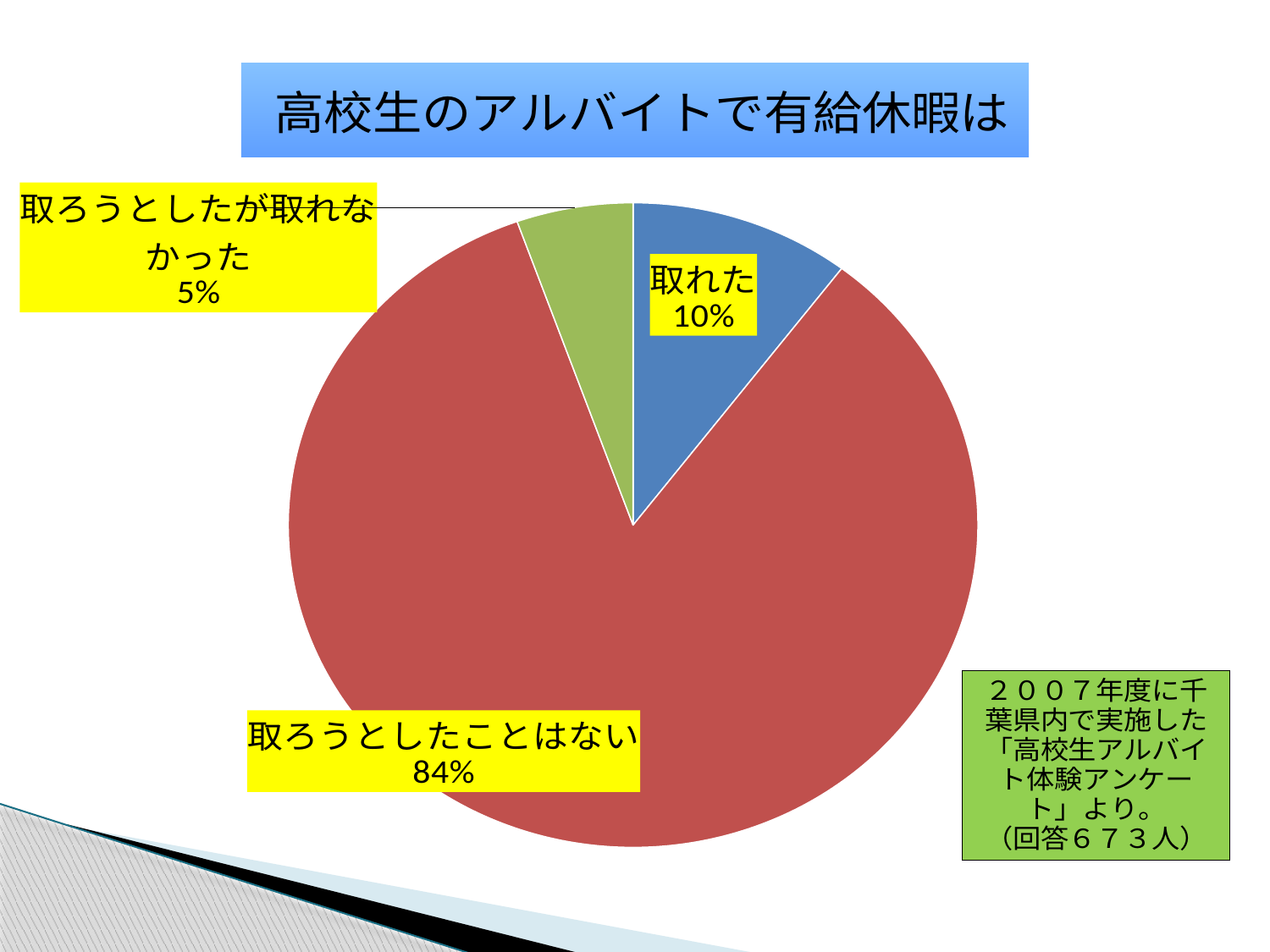
Which is larger, the slice for 取れた or the slice for 取ろうとしたが取れなかった? 取れた What colour is the slice for 取ろうとしたことはない? red Which slice of the pie is the largest? 取ろうとしたことはない What is the difference in percentage points between 取ろうとしたことはない and 取れた? 74 What is the title of the chart? 高校生のアルバイトで有給休暇は How many slices does the pie chart have? 3 Which slice of the pie is the smallest? 取ろうとしたが取れなかった What is the difference in percentage points between 取れた and 取ろうとしたが取れなかった? 5 What percentage of the pie is labelled 取ろうとしたが取れなかった? 5% What percentage of the pie is labelled 取れた? 10% What kind of chart is shown on the slide? pie chart What percentage of the pie is labelled 取ろうとしたことはない? 84%